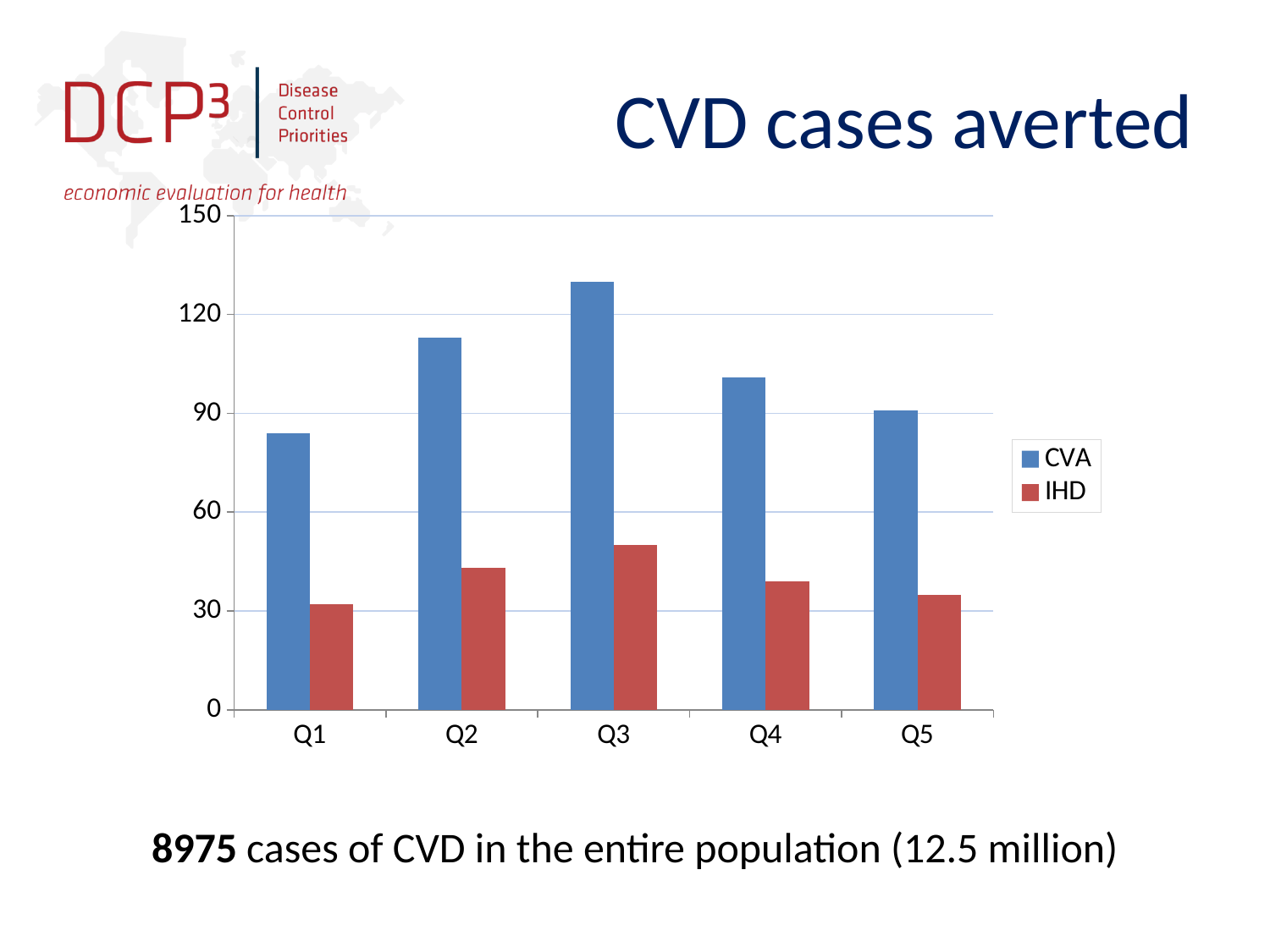
Is the CVA value for Q1 greater or less than 90? less Is the CVA value for Q3 greater or less than 120? greater What is the title of the chart? CVD cases averted How many series does the legend list? 2 Is the IHD value for Q2 greater or less than 30? greater What kind of chart is shown on the slide? bar chart Which quintile has the highest IHD value? Q3 Which is larger, the CVA value for Q2 or the CVA value for Q4? Q2 How many quintile categories are shown on the x axis? 5 Which quintile has the highest CVA value? Q3 Which quintile has the lowest CVA value? Q1